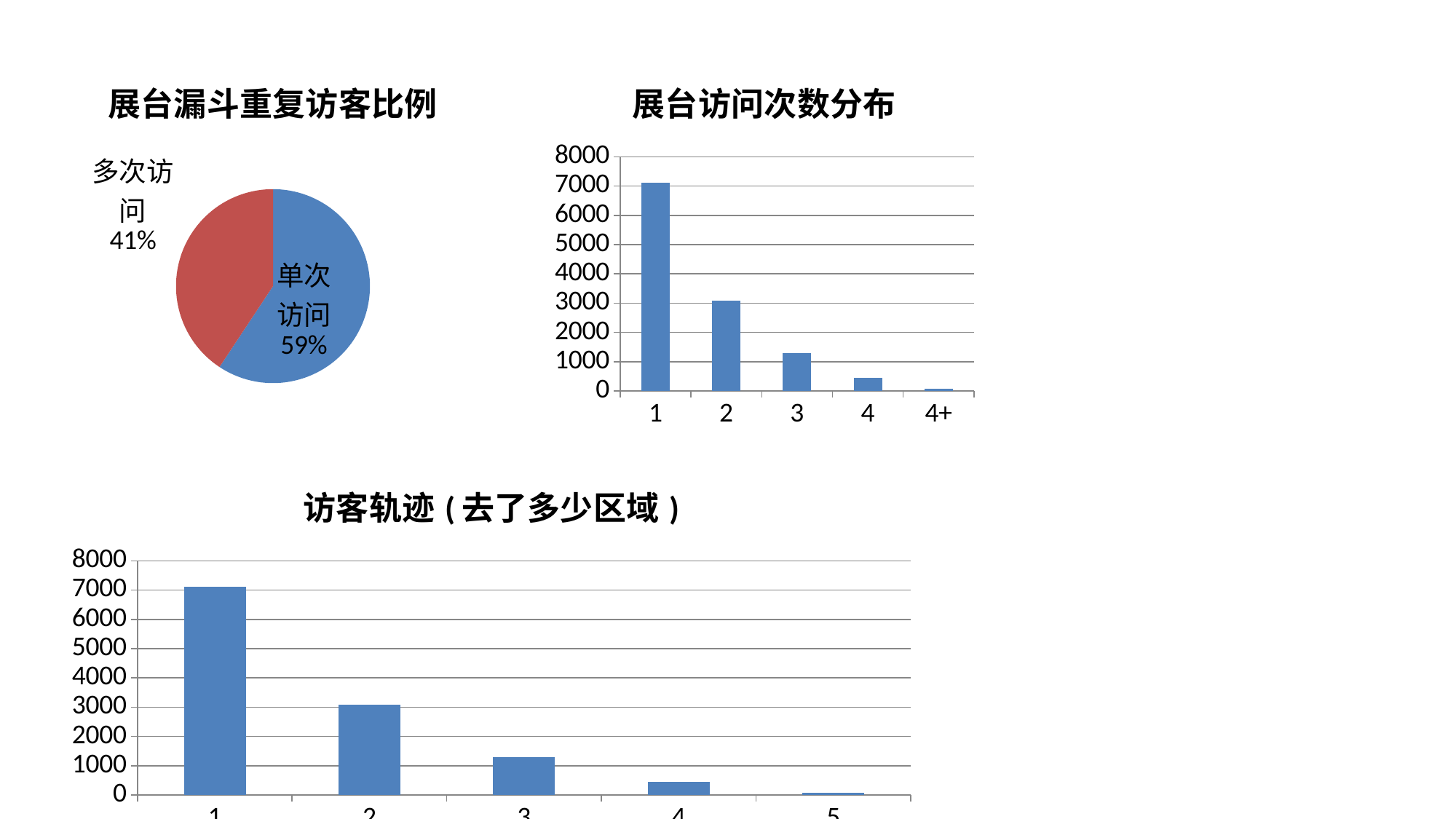
In the pie chart 展台漏斗重复访客比例, what percentage is shown for 多次访问? 41% In the pie chart 展台漏斗重复访客比例, what share of visitors is 单次访问? 59% What kind of chart is 展台漏斗重复访客比例? pie chart In the chart 访客轨迹（去了多少区域）, is the value for category 1 greater or less than 6000? greater In the chart 展台访问次数分布, is the value for category 2 greater or less than 2000? greater In the chart 访客轨迹（去了多少区域）, which is larger, the value for category 3 or category 4? 3 What kind of chart is 访客轨迹（去了多少区域）? bar chart In the chart 展台访问次数分布, which category has the highest value? 1 In the pie chart 展台漏斗重复访客比例, which slice is larger, 单次访问 or 多次访问? 单次访问 How many categories are shown on the x axis of the chart 展台访问次数分布? 5 In the chart 展台访问次数分布, which category has the lowest value? 4+ In the chart 展台访问次数分布, do the values rise or fall from category 1 to 4+? fall